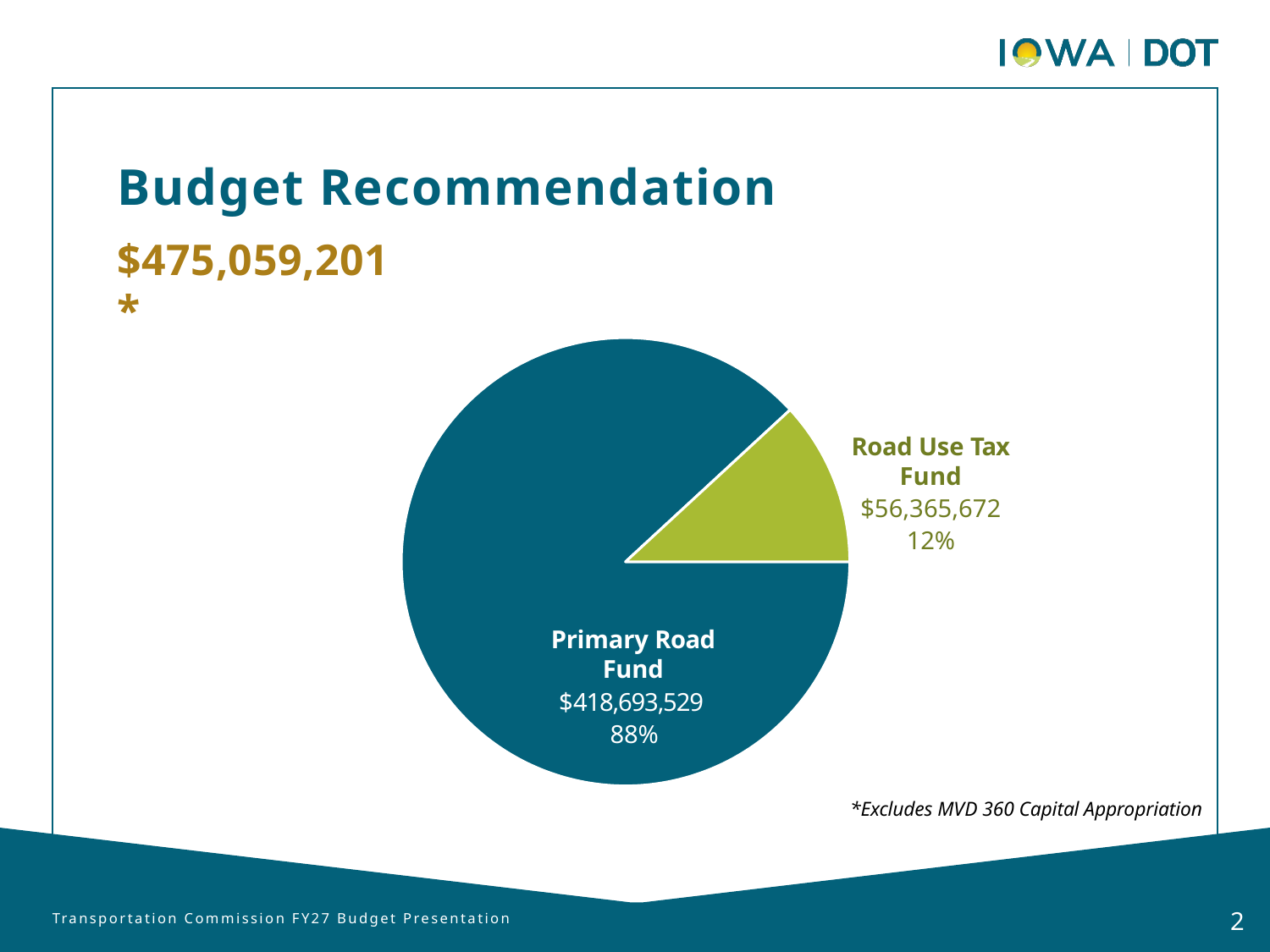
What colour is the Road Use Tax Fund slice? green What is the difference between the Primary Road Fund and the Road Use Tax Fund values? $362,327,857 What share of the pie does the Primary Road Fund represent? 88% What share of the pie does the Road Use Tax Fund represent? 12% Which fund has the smallest slice of the pie? Road Use Tax Fund What is the value for the Primary Road Fund? $418,693,529 What is the total budget recommendation shown on the slide? $475,059,201 What is the value for the Road Use Tax Fund? $56,365,672 How many slices does the pie chart have? 2 Which is larger, the Primary Road Fund or the Road Use Tax Fund? Primary Road Fund What kind of chart is shown on the slide? pie chart Which fund has the largest slice of the pie? Primary Road Fund